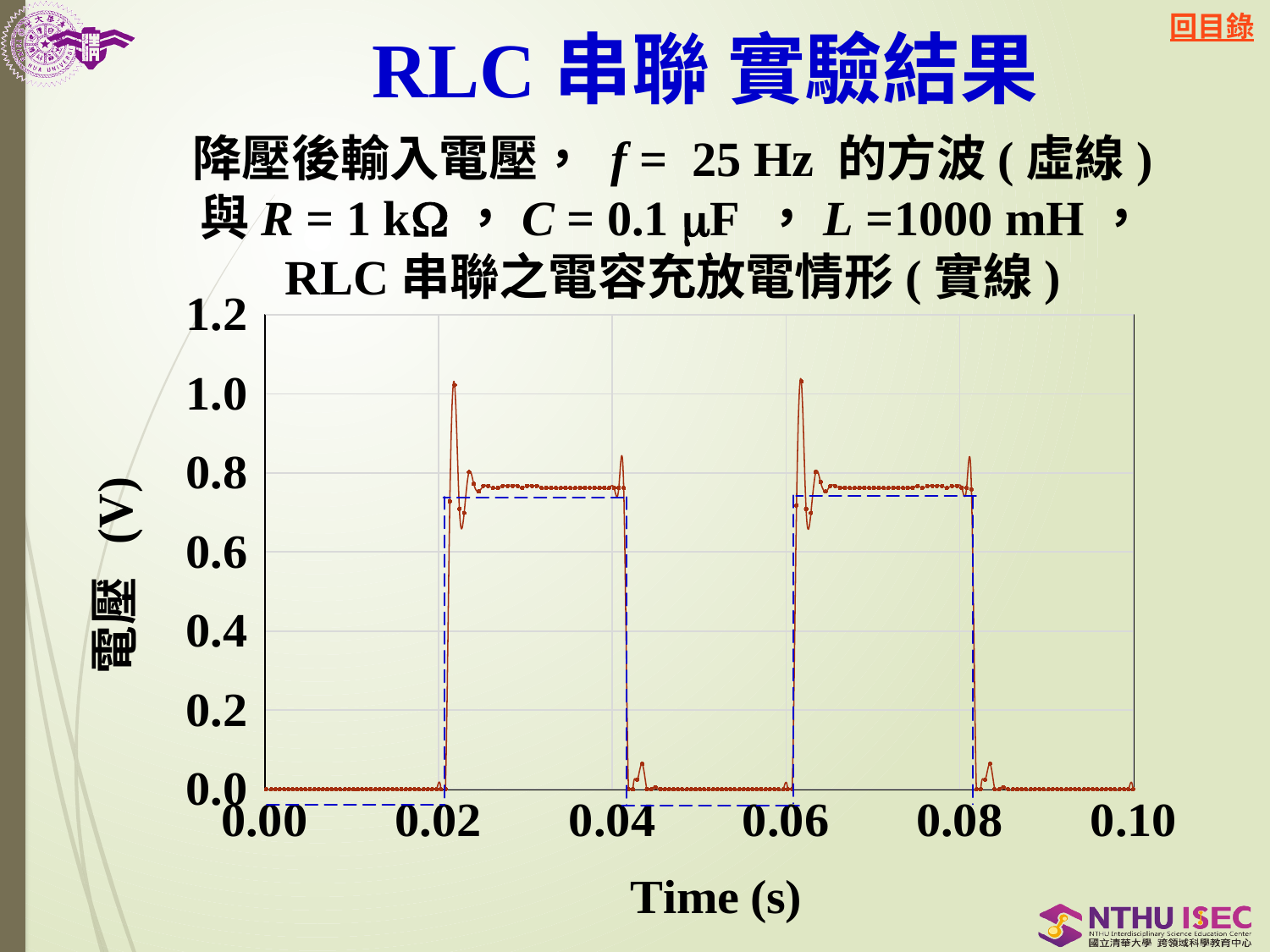
Which line reaches a higher peak value, the solid line or the dashed line? the solid line What is the label of the x axis of the chart? Time (s) What is the maximum value shown on the y axis of the chart? 1.2 What kind of chart is shown on the slide? line chart Is the value of the solid line at 0.01 s greater or less than 0.2? less How many square-wave pulses of the dashed line are shown within the plotted time range? 2 Is the high level of the dashed square wave greater or less than 0.8? less What is the label of the y axis of the chart? 電壓 (V) What is the maximum value shown on the x axis of the chart? 0.10 Is the peak value of the solid line near 0.02 s greater or less than 0.8? greater How many tick labels are shown on the x axis of the chart? 6